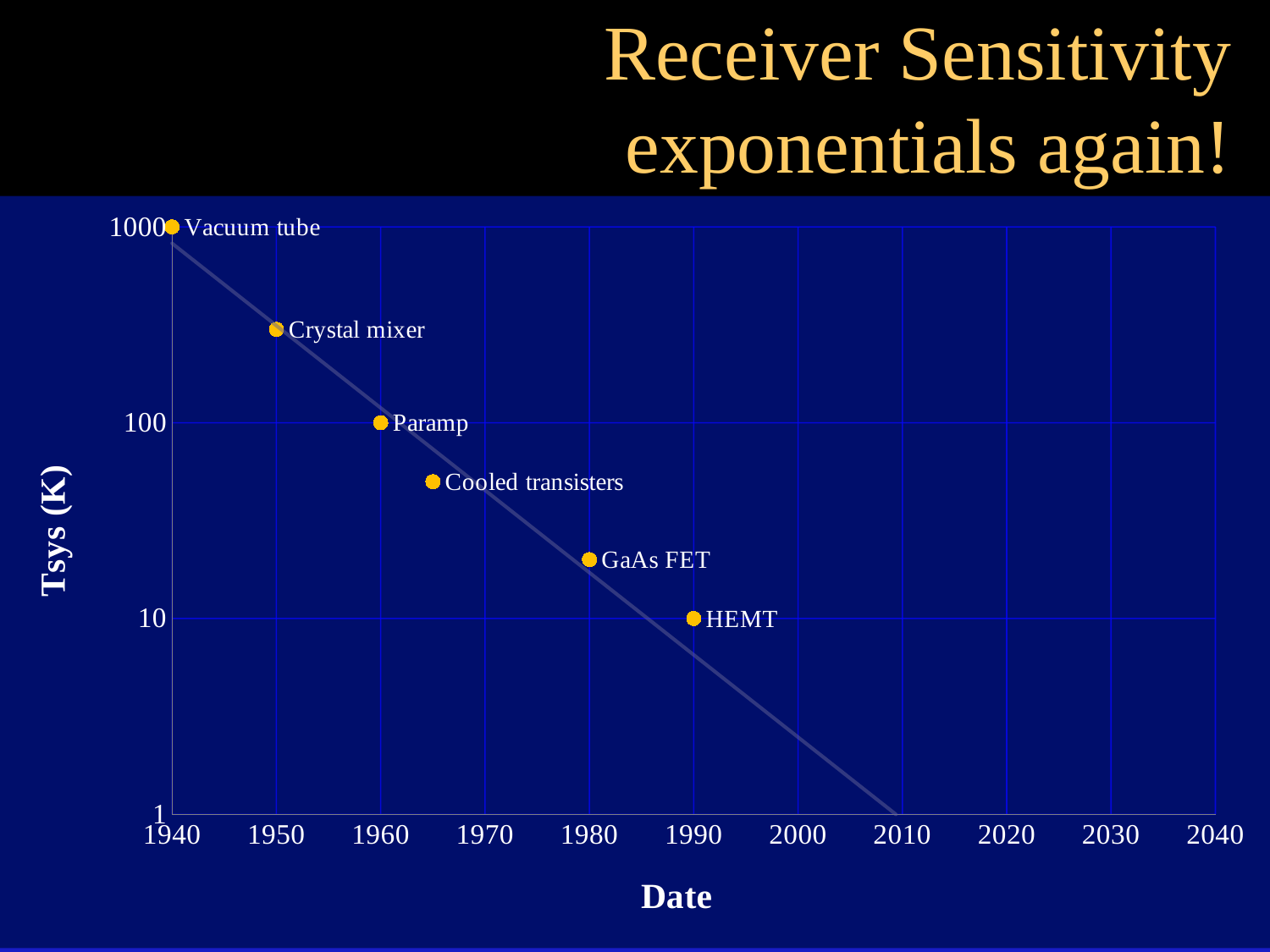
Which labelled point has the lowest Tsys value? HEMT What is the Tsys value for the Vacuum tube point? 1000 Is the Tsys value for GaAs FET greater or less than 100? less Do the Tsys values rise or fall as the date increases? fall Is the Tsys value for Cooled transisters greater or less than 10? greater What is the label of the vertical axis? Tsys (K) Which labelled point has the highest Tsys value? Vacuum tube Is the Tsys value for Crystal mixer greater or less than 100? greater What is the Tsys value for the Paramp point? 100 What is the Tsys value for the HEMT point? 10 Which has a higher Tsys value, Paramp or GaAs FET? Paramp How many labelled data points are plotted on the chart? 6